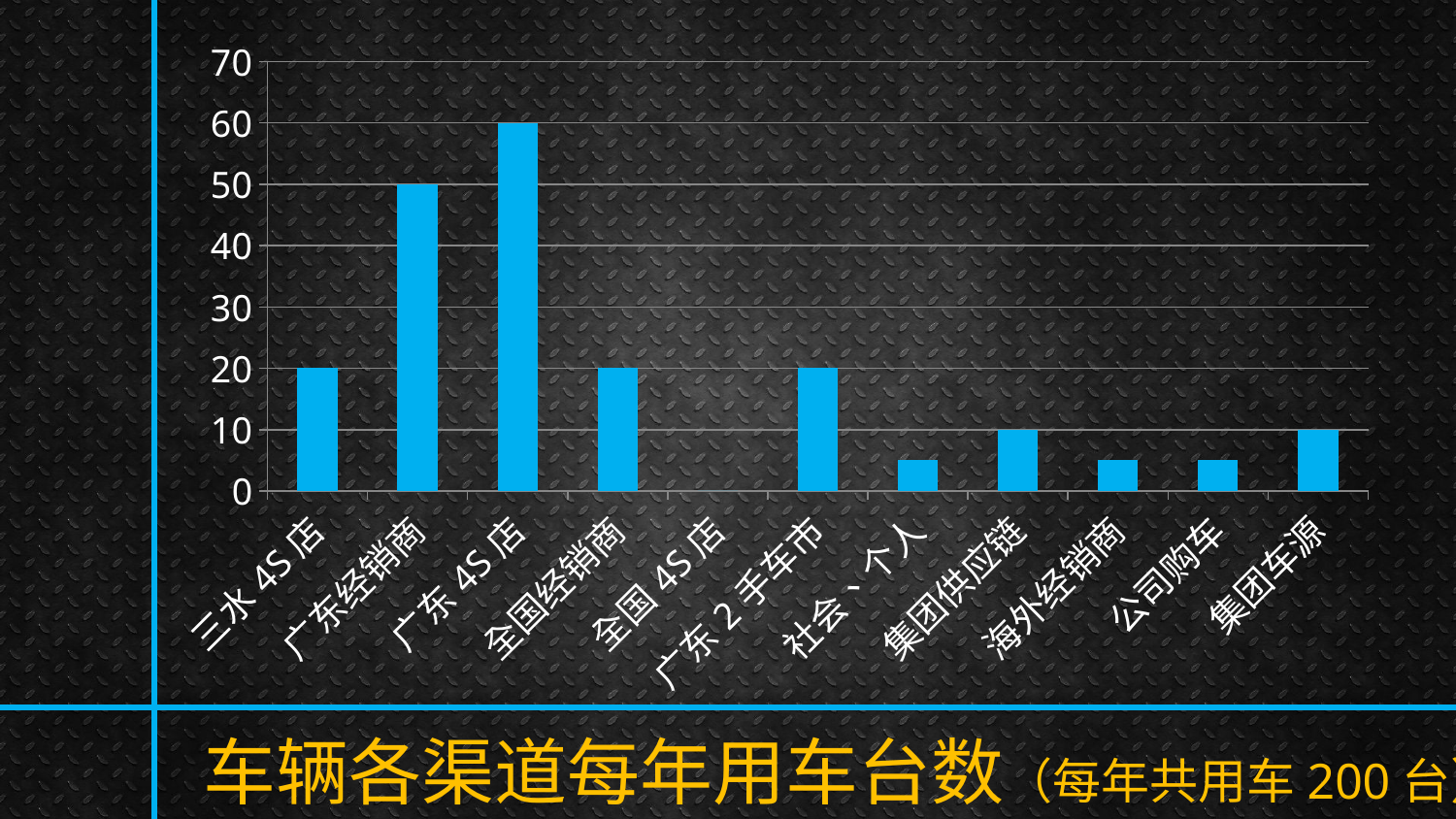
What kind of chart is shown on the slide? bar chart What is the value for 广东经销商? 50 Which is larger, the value for 三水4S店 or the value for 集团车源? 三水4S店 How many categories are shown on the x axis? 11 Is the value for 广东2手车市 greater or less than 10? greater What is the value for 广东4S店? 60 Which category has the highest value? 广东4S店 Is the value for 海外经销商 greater or less than 10? less What is the title shown below the chart? 车辆各渠道每年用车台数 What is the value for 三水4S店? 20 What is the value for 集团供应链? 10 What is the difference between the values for 广东4S店 and 广东经销商? 10